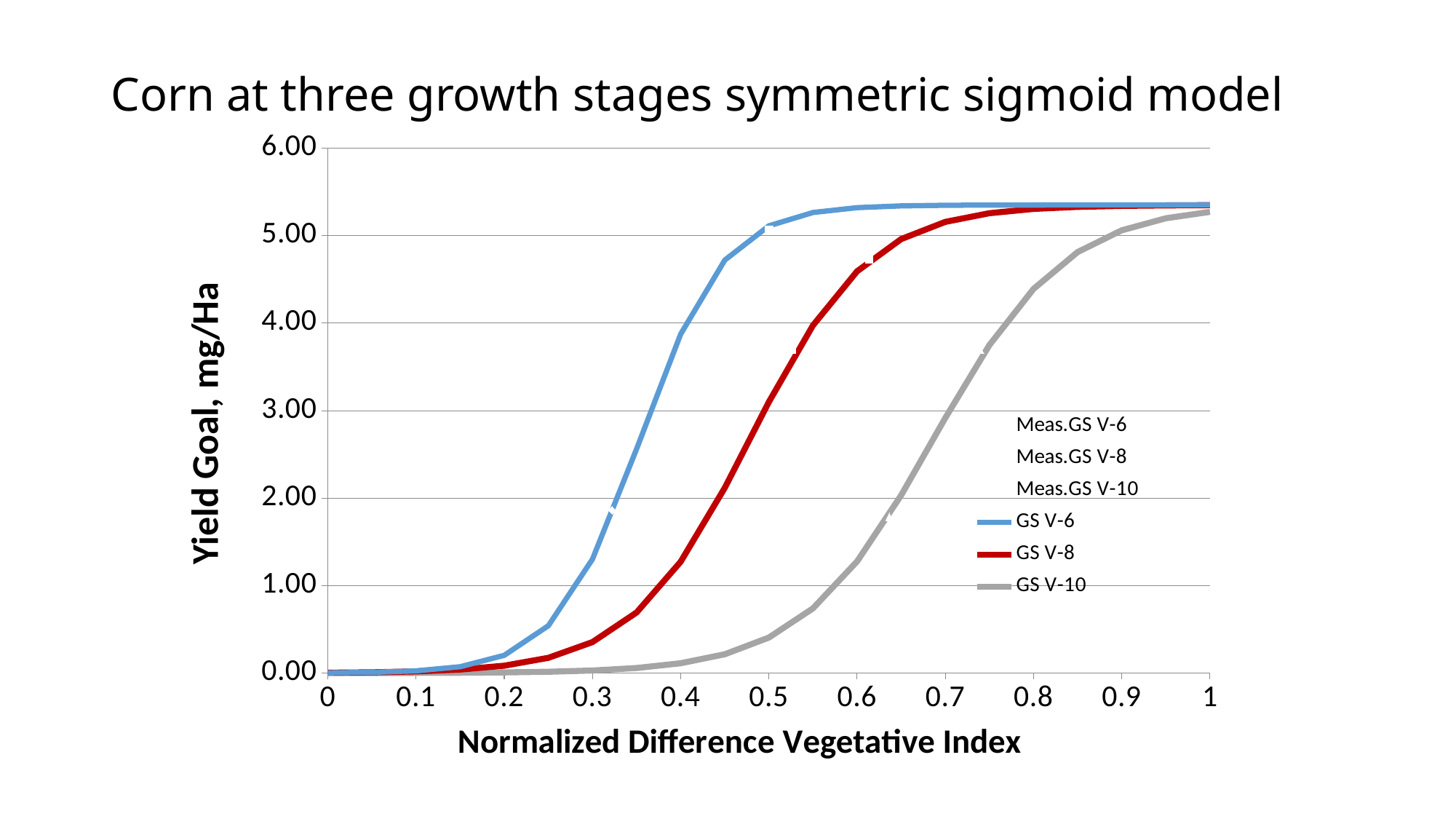
What is the label of the y axis? Yield Goal, mg/Ha How many entries does the legend list? 6 Do the values of the GS V-10 line rise or fall as the Normalized Difference Vegetative Index increases? Rise Is the value of the GS V-10 line at an NDVI of 0.8 greater or less than 4.00? greater Is the value of the GS V-8 line at an NDVI of 0.4 greater or less than 1.00? greater Is the value of the GS V-10 line at an NDVI of 0.5 greater or less than 1.00? less What kind of chart is shown on the slide? Line chart At an NDVI of 0.6, which line has the larger value, GS V-8 or GS V-10? GS V-8 Which line has the highest value at an NDVI of 0.4? GS V-6 At an NDVI of 0.5, which line has the larger value, GS V-6 or GS V-10? GS V-6 What is the title of the chart? Corn at three growth stages symmetric sigmoid model